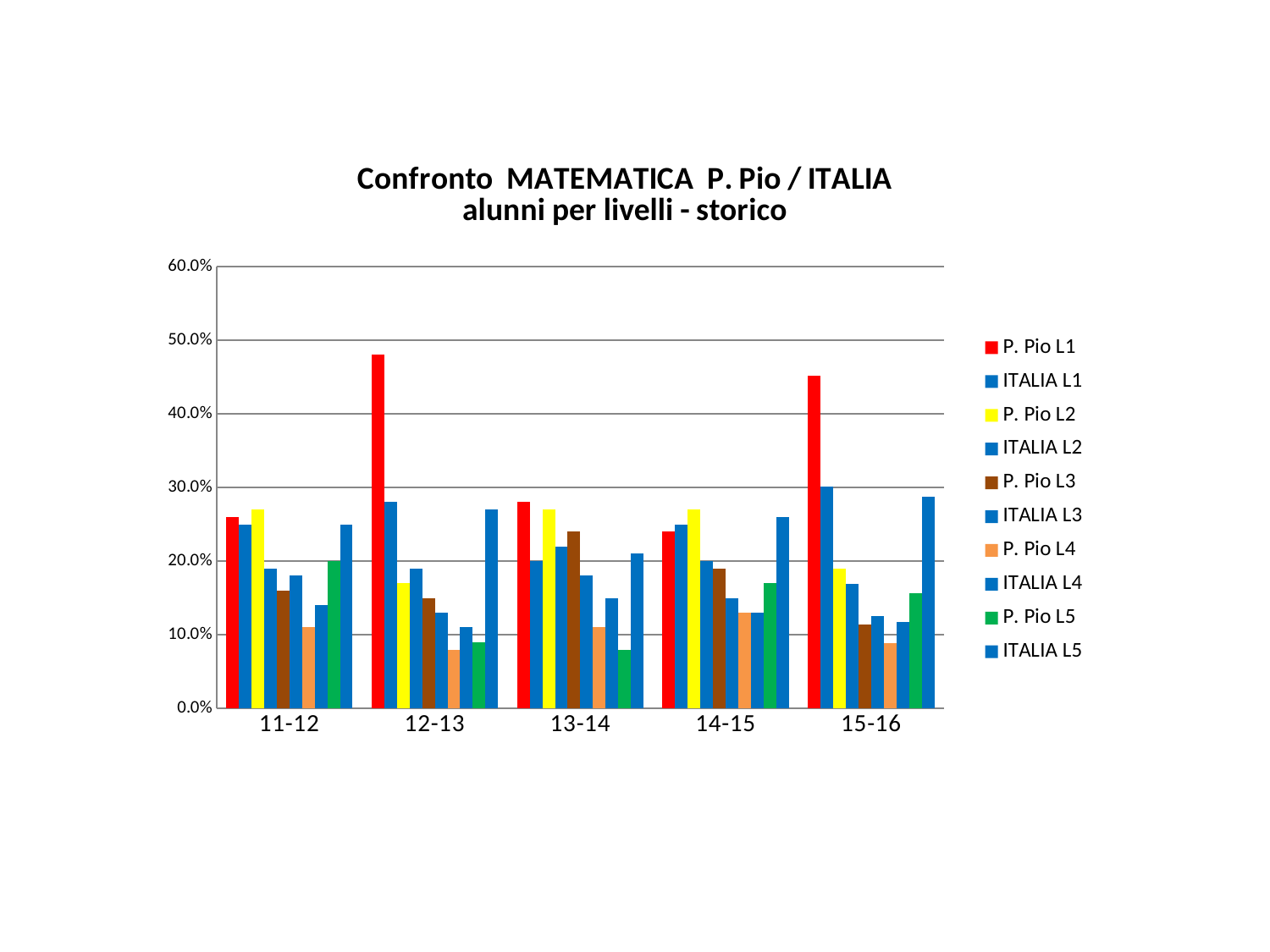
How many series does the legend list? 10 Is the value for ITALIA L1 in 15-16 greater or less than 20.0%? greater In 13-14, which is larger: P. Pio L3 or ITALIA L3? P. Pio L3 In 15-16, which is larger: P. Pio L1 or ITALIA L1? P. Pio L1 Which series has the shortest bar in the 13-14 group? P. Pio L5 How many school-year categories are shown on the x axis? 5 Is the value for P. Pio L4 in 12-13 greater or less than 10.0%? less What kind of chart is shown on the slide? bar chart Is the value for P. Pio L1 in 12-13 greater or less than 40.0%? greater Which series has the tallest bar in the 12-13 group? P. Pio L1 What colour represents the P. Pio L1 series in the legend? red What is the title of the chart? Confronto MATEMATICA P. Pio / ITALIA alunni per livelli - storico